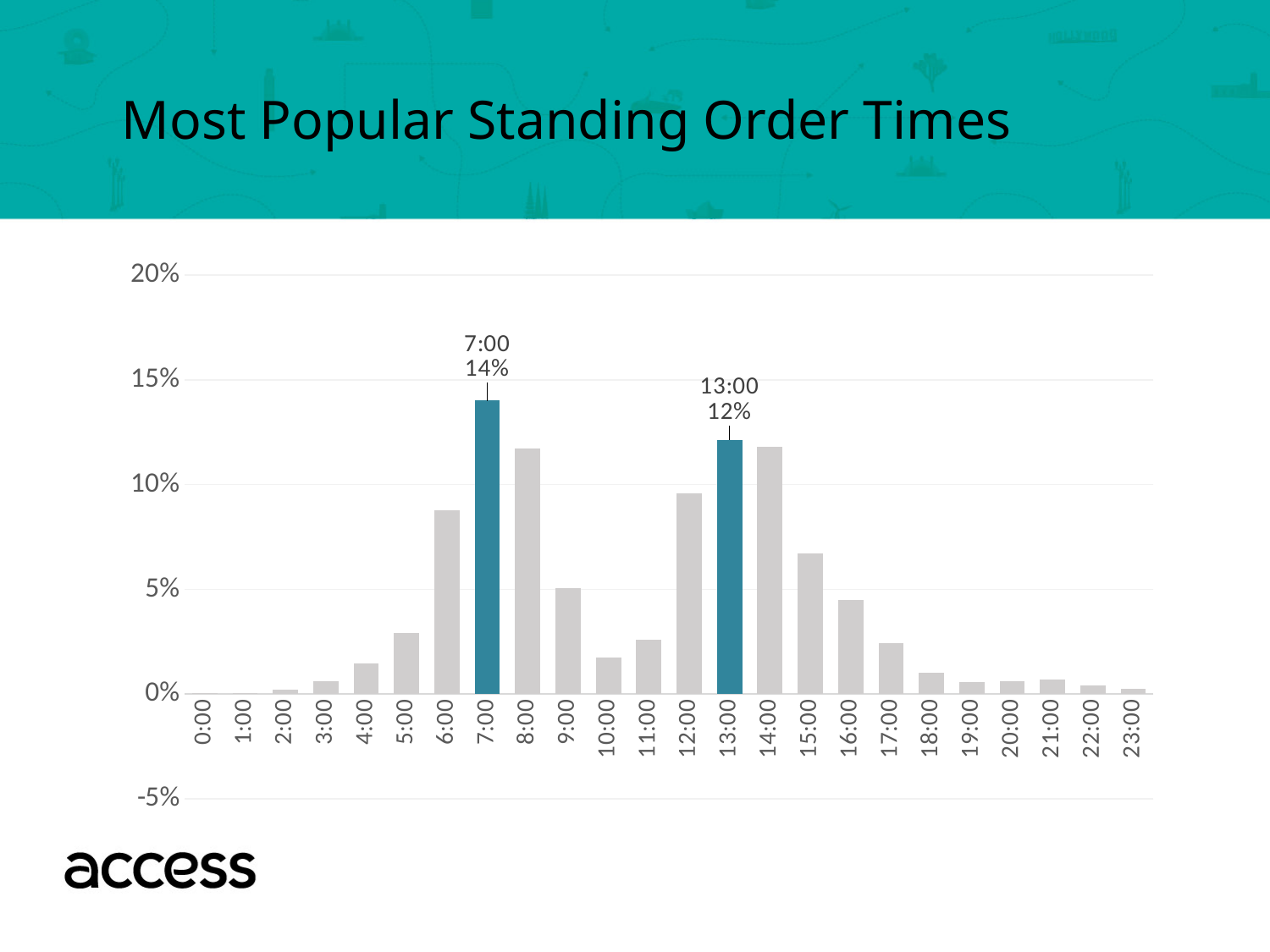
How many time categories are shown on the x axis? 24 Which is larger, the value for 7:00 or the value for 13:00? 7:00 What is the value for 7:00? 14% What is the difference between the values for 7:00 and 13:00? 2% Is the value for 8:00 greater or less than 10%? greater Which time has the highest value? 7:00 What is the value for 13:00? 12% Is the value for 17:00 greater or less than 5%? less Is the value for 6:00 greater or less than 10%? less What kind of chart is shown on the slide? bar chart Do the values rise or fall from 7:00 to 10:00? fall What is the title of the chart? Most Popular Standing Order Times